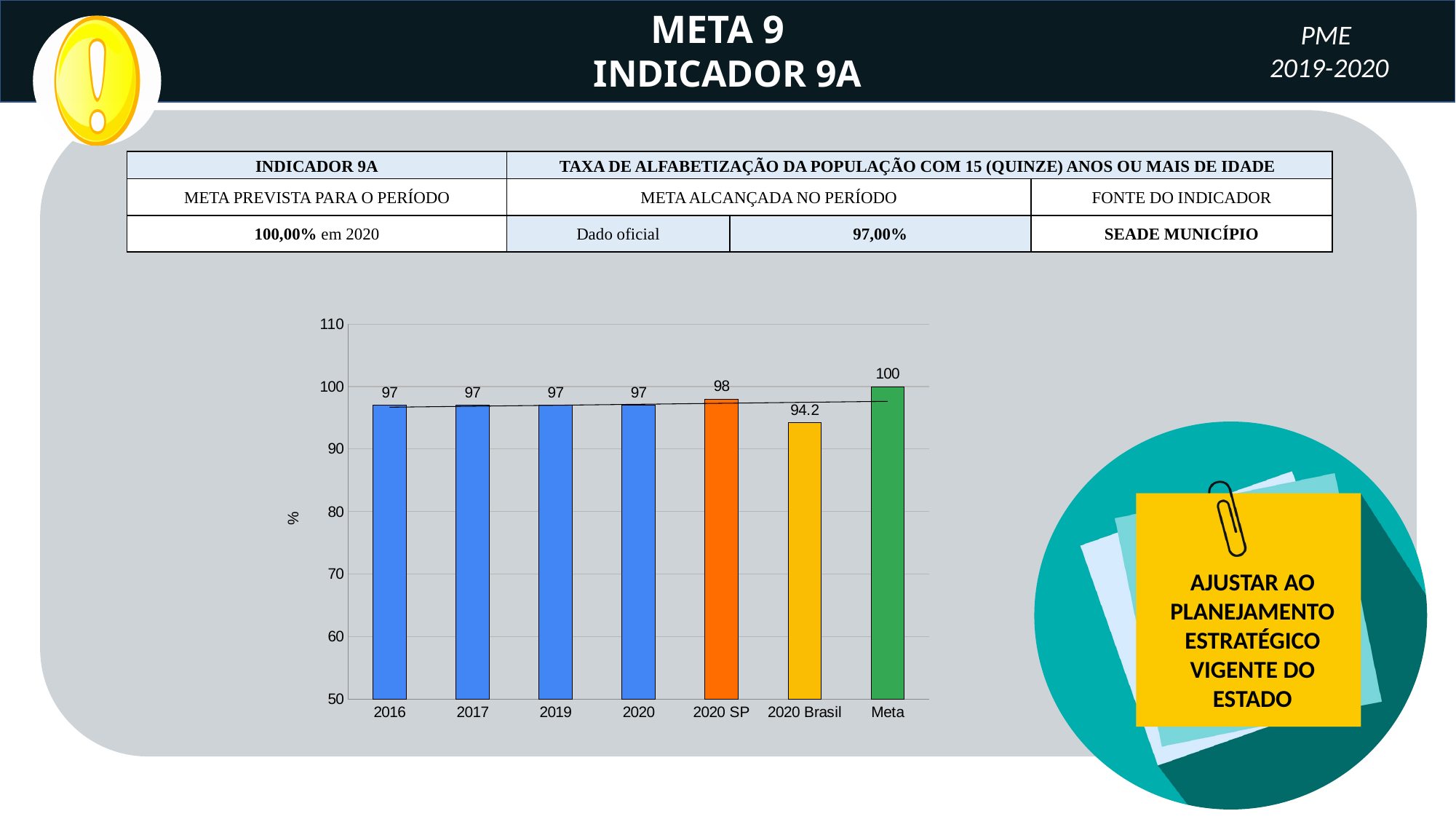
What is the value for 2020 Brasil in the chart? 94.2 What is the value for 2016 in the chart? 97 Which category has the highest value in the chart? Meta What type of chart is shown on the slide? bar chart Which category has the lowest value in the chart? 2020 Brasil What label is shown on the vertical axis of the chart? % Is the value for 2020 Brasil greater or less than 90? greater What is the value for 2020 SP in the chart? 98 What is the value for Meta in the chart? 100 Which is larger, the value for 2020 SP or the value for 2020 Brasil? 2020 SP How many bars (categories) does the chart show? 7 What is the difference between the Meta value and the 2020 value? 3